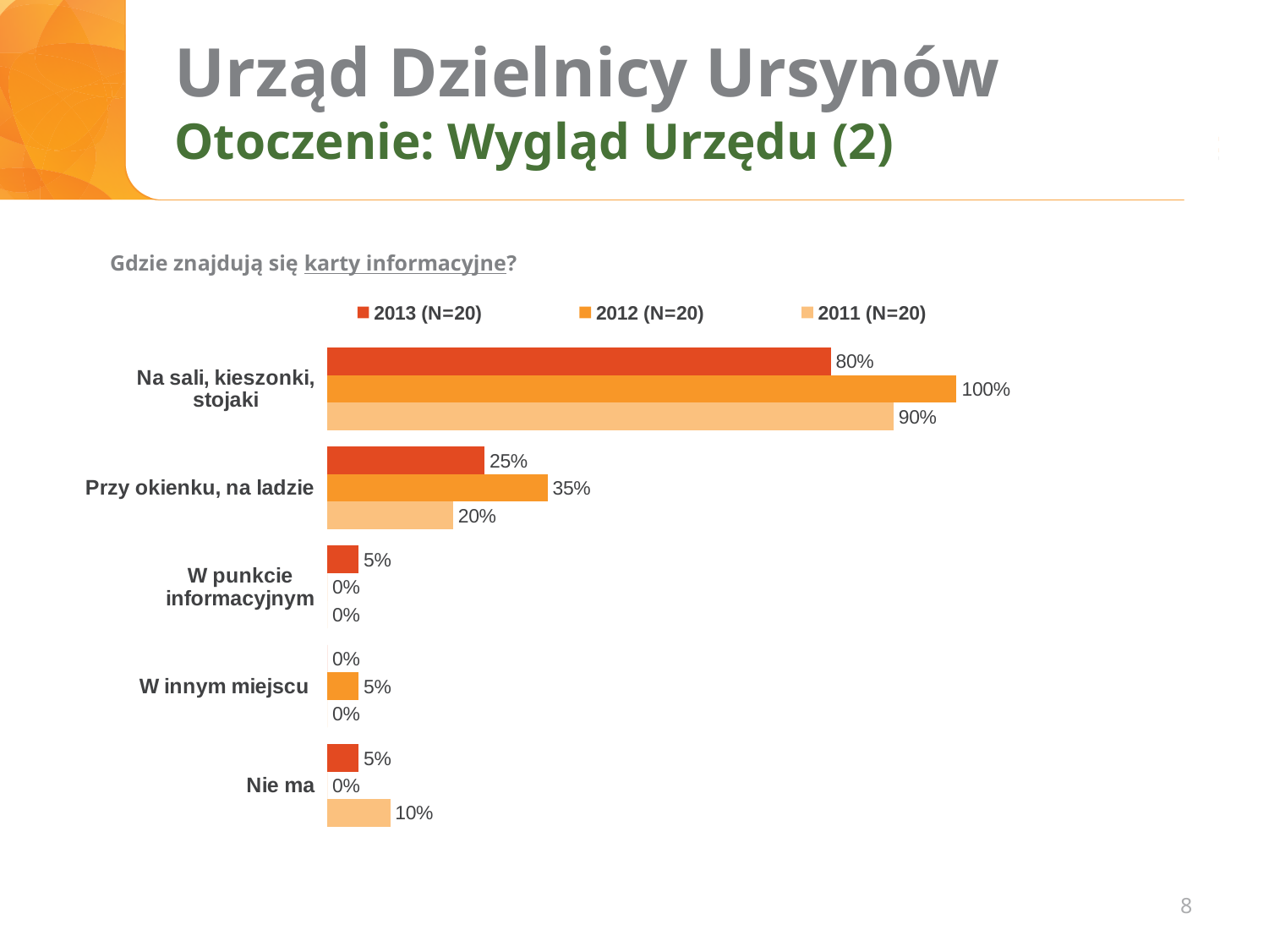
What is the value for 'Na sali, kieszonki, stojaki' in the 2012 (N=20) series? 100% What is the value for 'Przy okienku, na ladzie' in the 2013 (N=20) series? 25% Which is larger for 'Przy okienku, na ladzie': the 2013 (N=20) value or the 2011 (N=20) value? 2013 (N=20) What kind of chart is shown on the slide? Bar chart How many series does the legend list? 3 How many categories are shown on the chart? 5 What is the difference between the 2012 (N=20) and 2013 (N=20) values for 'Na sali, kieszonki, stojaki'? 20% Which category has the highest value in the 2013 (N=20) series? Na sali, kieszonki, stojaki What is the value for 'Nie ma' in the 2011 (N=20) series? 10% What is the difference between the 2012 (N=20) and 2011 (N=20) values for 'Przy okienku, na ladzie'? 15% What is the value for 'W innym miejscu' in the 2012 (N=20) series? 5%